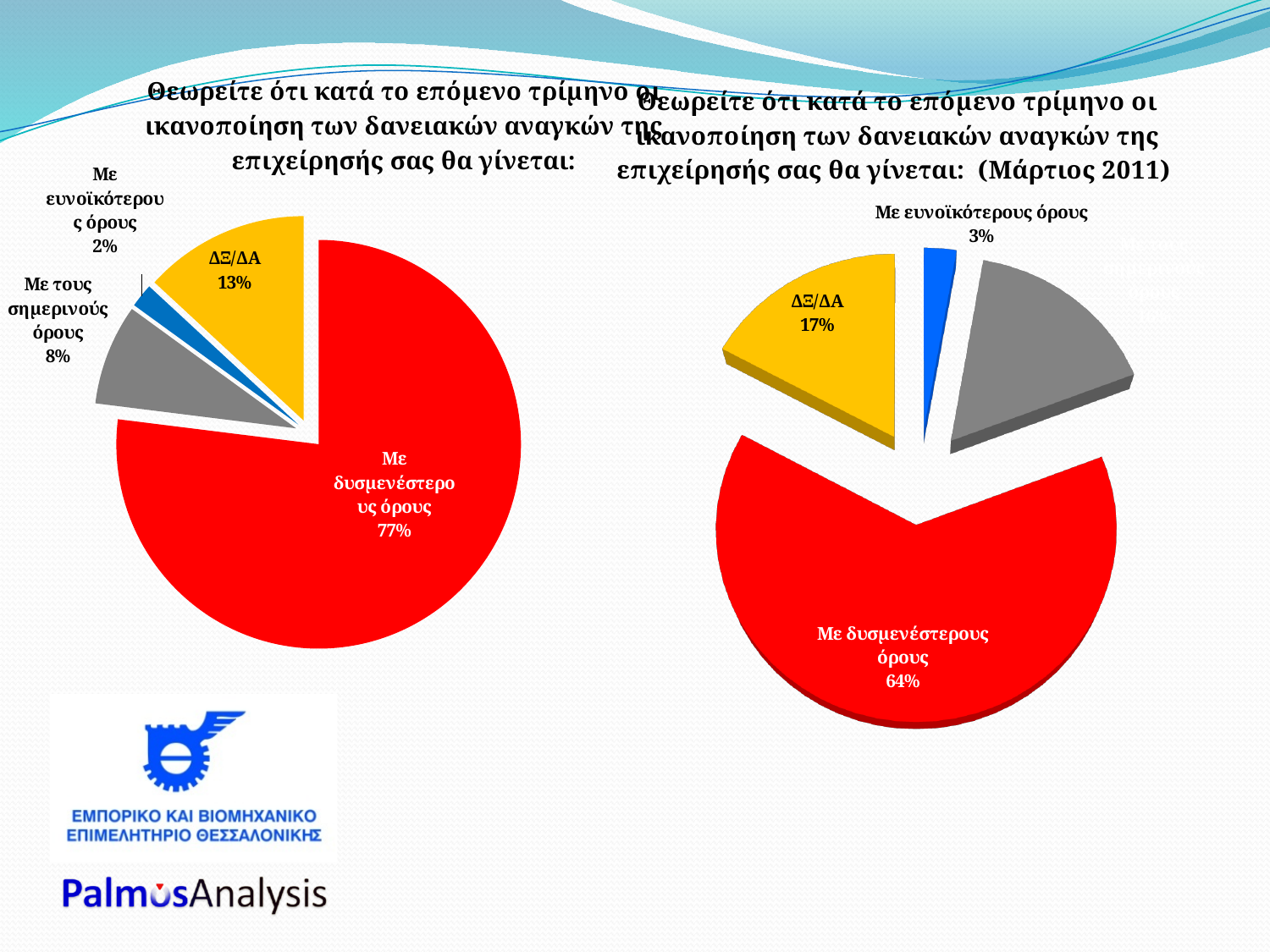
In the left pie chart, what percentage is shown for 'Με ευνοϊκότερους όρους'? 2% In the left pie chart, what percentage is shown for 'Με τους σημερινούς όρους'? 8% What type of chart is used on the left of the slide? Pie chart In the left pie chart, what percentage is shown for 'ΔΞ/ΔΑ'? 13% Which is larger: the 'ΔΞ/ΔΑ' share in the left pie chart or in the right pie chart (Μάρτιος 2011)? Right pie chart (Μάρτιος 2011) In the right pie chart (Μάρτιος 2011), what percentage is shown for 'ΔΞ/ΔΑ'? 17% In the left pie chart, what share is labelled for 'Με δυσμενέστερους όρους'? 77% In the left pie chart, which category has the largest slice? Με δυσμενέστερους όρους In the left pie chart, which category has the smallest slice? Με ευνοϊκότερους όρους What is the difference between the 'Με δυσμενέστερους όρους' share in the left pie chart and in the right pie chart (Μάρτιος 2011)? 13 percentage points In the right pie chart (Μάρτιος 2011), what percentage is shown for 'Με δυσμενέστερους όρους'? 64% In the right pie chart (Μάρτιος 2011), what percentage is shown for 'Με ευνοϊκότερους όρους'? 3%